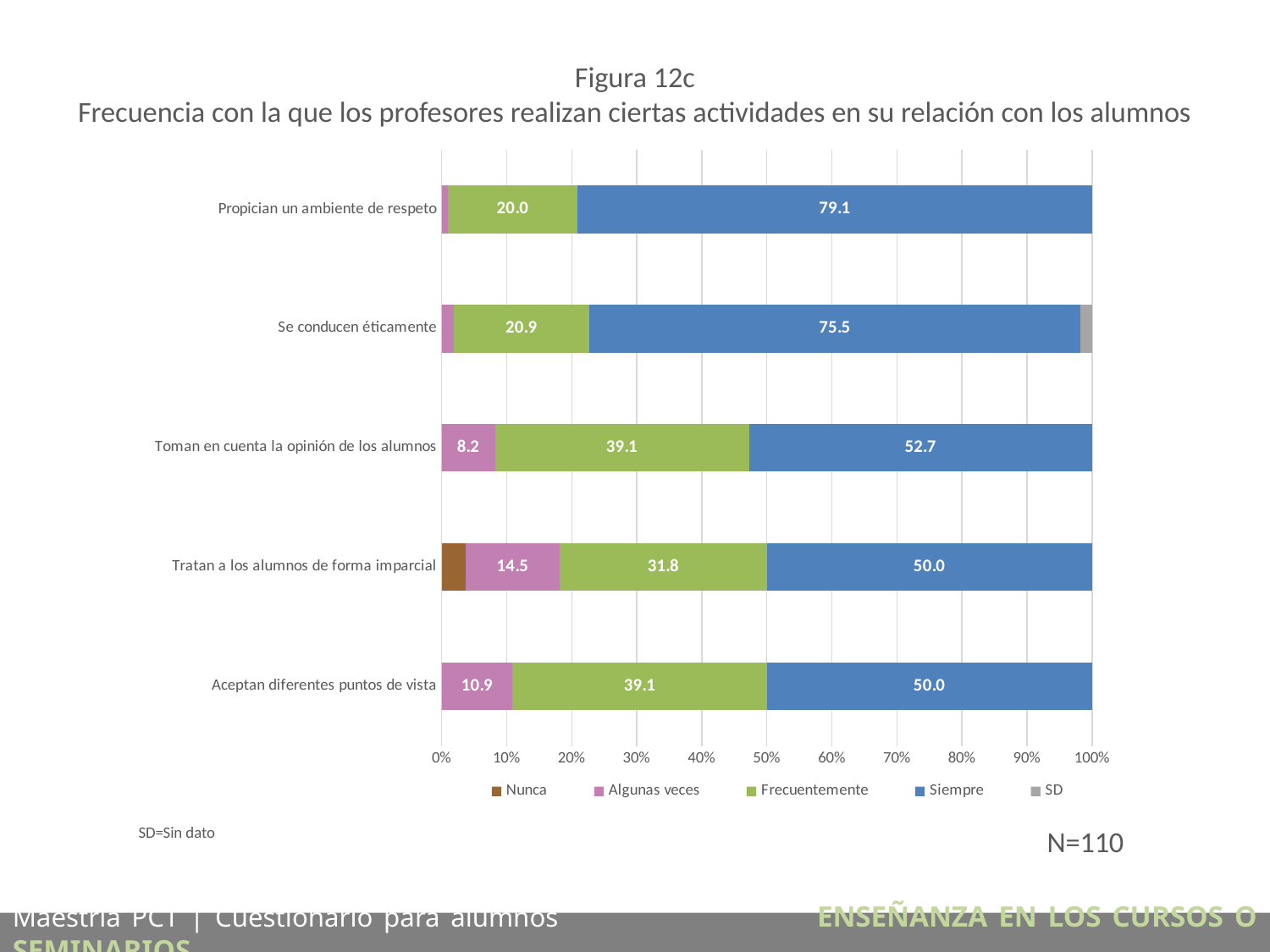
What kind of chart is shown on the slide? Stacked bar chart Which category has the highest 'Siempre' value? Propician un ambiente de respeto Which is larger: the 'Frecuentemente' value for 'Aceptan diferentes puntos de vista' or for 'Tratan a los alumnos de forma imparcial'? Aceptan diferentes puntos de vista What is the 'Siempre' value for 'Propician un ambiente de respeto'? 79.1 What is the sample size (N) shown on the slide? N=110 How many series does the legend list? 5 Which category has the highest 'Algunas veces' value? Tratan a los alumnos de forma imparcial What is the 'Algunas veces' value for 'Toman en cuenta la opinión de los alumnos'? 8.2 How many categories are shown on the chart? 5 What is the difference between the 'Siempre' values for 'Propician un ambiente de respeto' and 'Se conducen éticamente'? 3.6 What is the 'Frecuentemente' value for 'Se conducen éticamente'? 20.9 What is the 'Frecuentemente' value for 'Tratan a los alumnos de forma imparcial'? 31.8